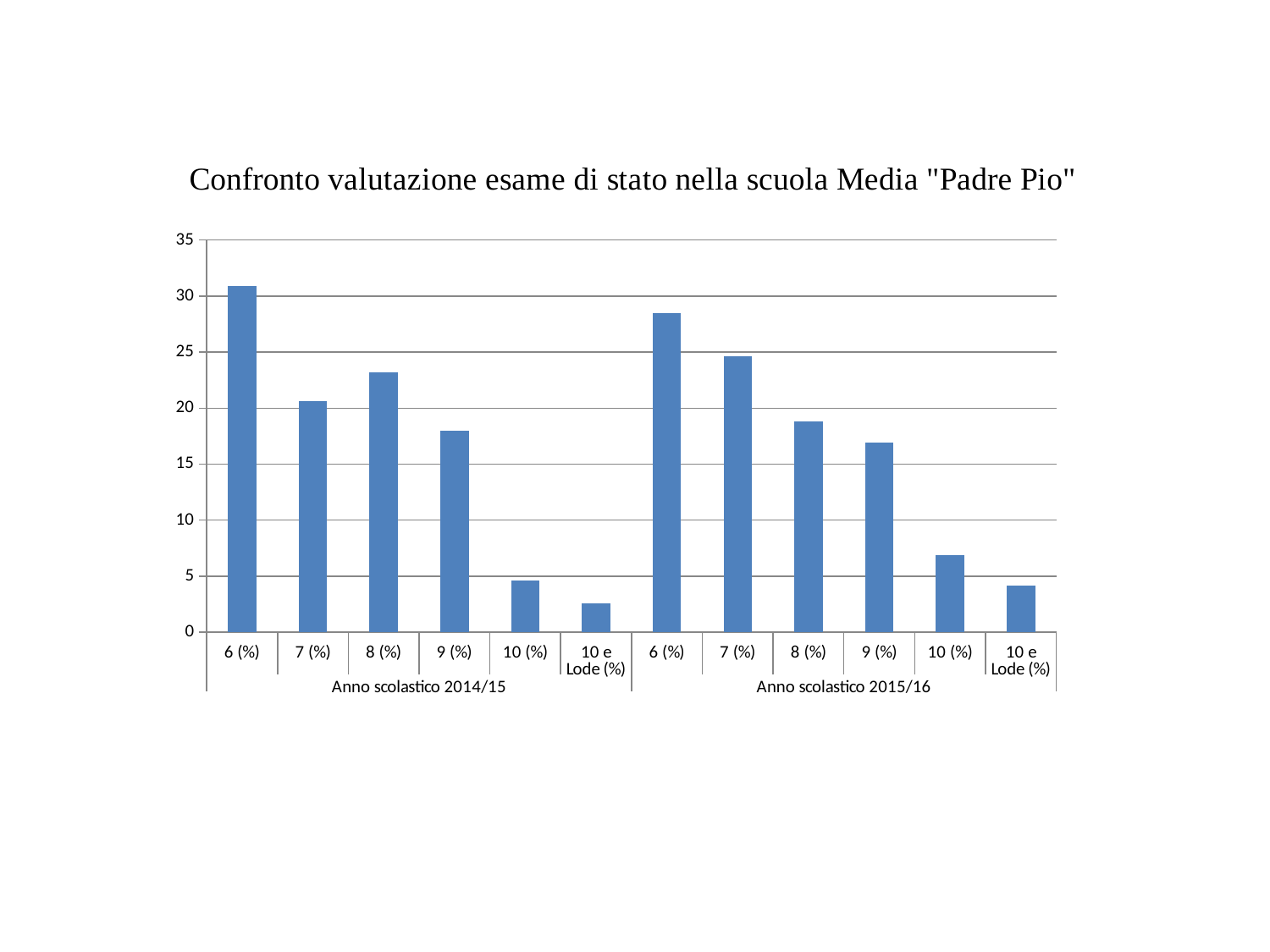
Within the Anno scolastico 2015/16 group, do the values rise or fall from 6 (%) to 10 e Lode (%)? fall Is the value for 10 (%) in Anno scolastico 2015/16 greater or less than 5? greater Which is larger: the value for 7 (%) in Anno scolastico 2014/15 or 7 (%) in Anno scolastico 2015/16? 7 (%) in Anno scolastico 2015/16 Which is larger: the value for 8 (%) in Anno scolastico 2014/15 or 8 (%) in Anno scolastico 2015/16? 8 (%) in Anno scolastico 2014/15 What is the title of the chart? Confronto valutazione esame di stato nella scuola Media "Padre Pio" Is the value for 10 (%) in Anno scolastico 2014/15 greater or less than 5? less Is the value for 7 (%) in Anno scolastico 2015/16 greater or less than 20? greater How many bars are plotted in the chart in total? 12 What kind of chart is shown on the slide? bar chart Which category has the highest bar in the chart? 6 (%) in Anno scolastico 2014/15 Which category has the lowest bar in the chart? 10 e Lode (%) in Anno scolastico 2014/15